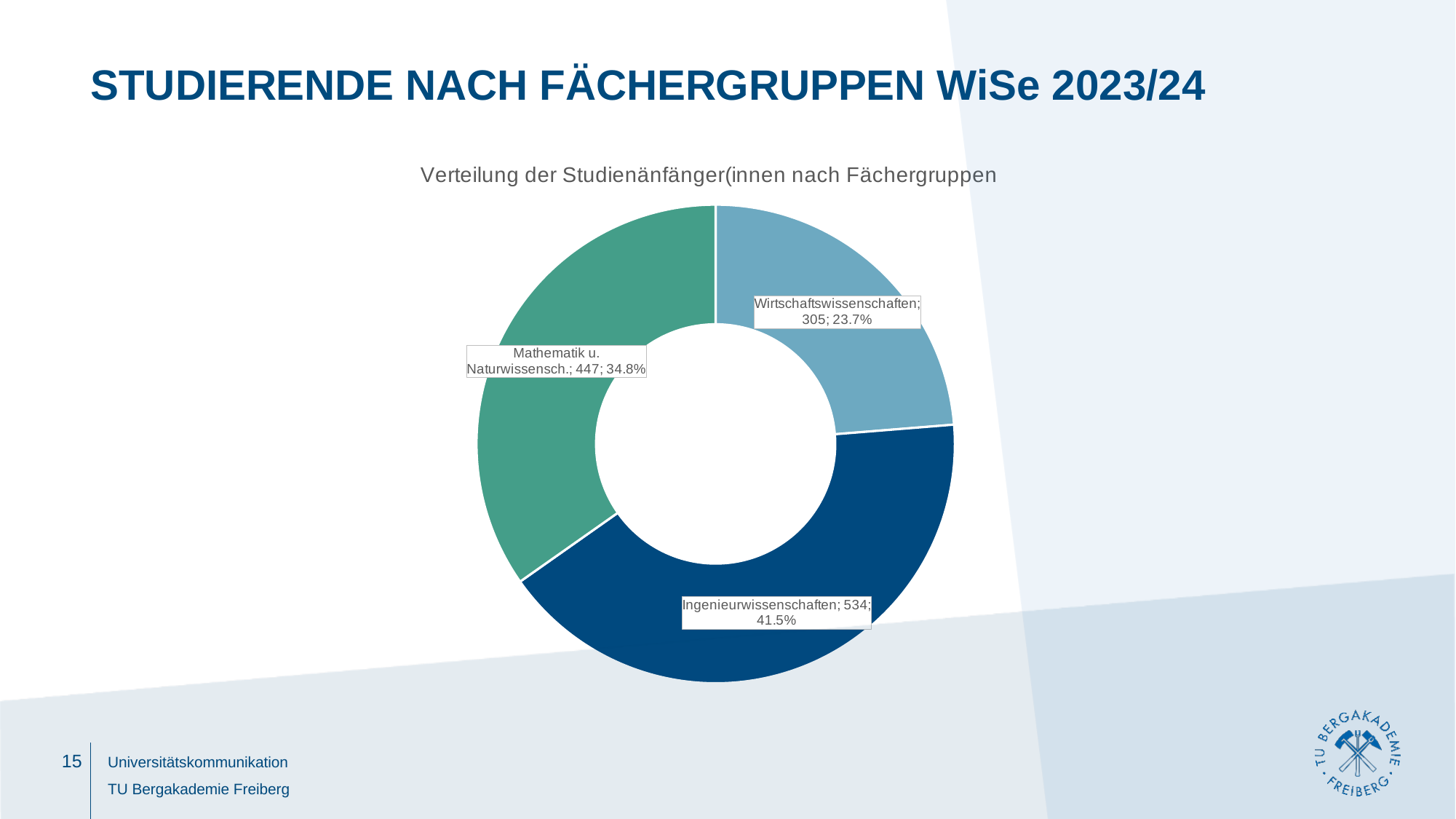
How many subject groups are shown in the chart? 3 What is the title of the chart? Verteilung der Studienänfänger(innen nach Fächergruppen What is the difference in student numbers between Ingenieurwissenschaften and Wirtschaftswissenschaften? 229 Which is larger, the value for Mathematik u. Naturwissensch. or for Ingenieurwissenschaften? Ingenieurwissenschaften What percentage share does Mathematik u. Naturwissensch. have? 34.8% What is the difference between the values for Mathematik u. Naturwissensch. and Wirtschaftswissenschaften? 142 What share of the chart does Wirtschaftswissenschaften represent? 23.7% What kind of chart is shown on the slide? Doughnut (pie) chart Which subject group has the largest share? Ingenieurwissenschaften What is the value for Mathematik u. Naturwissensch.? 447 How many students are in the Ingenieurwissenschaften group? 534 Which subject group has the smallest share? Wirtschaftswissenschaften